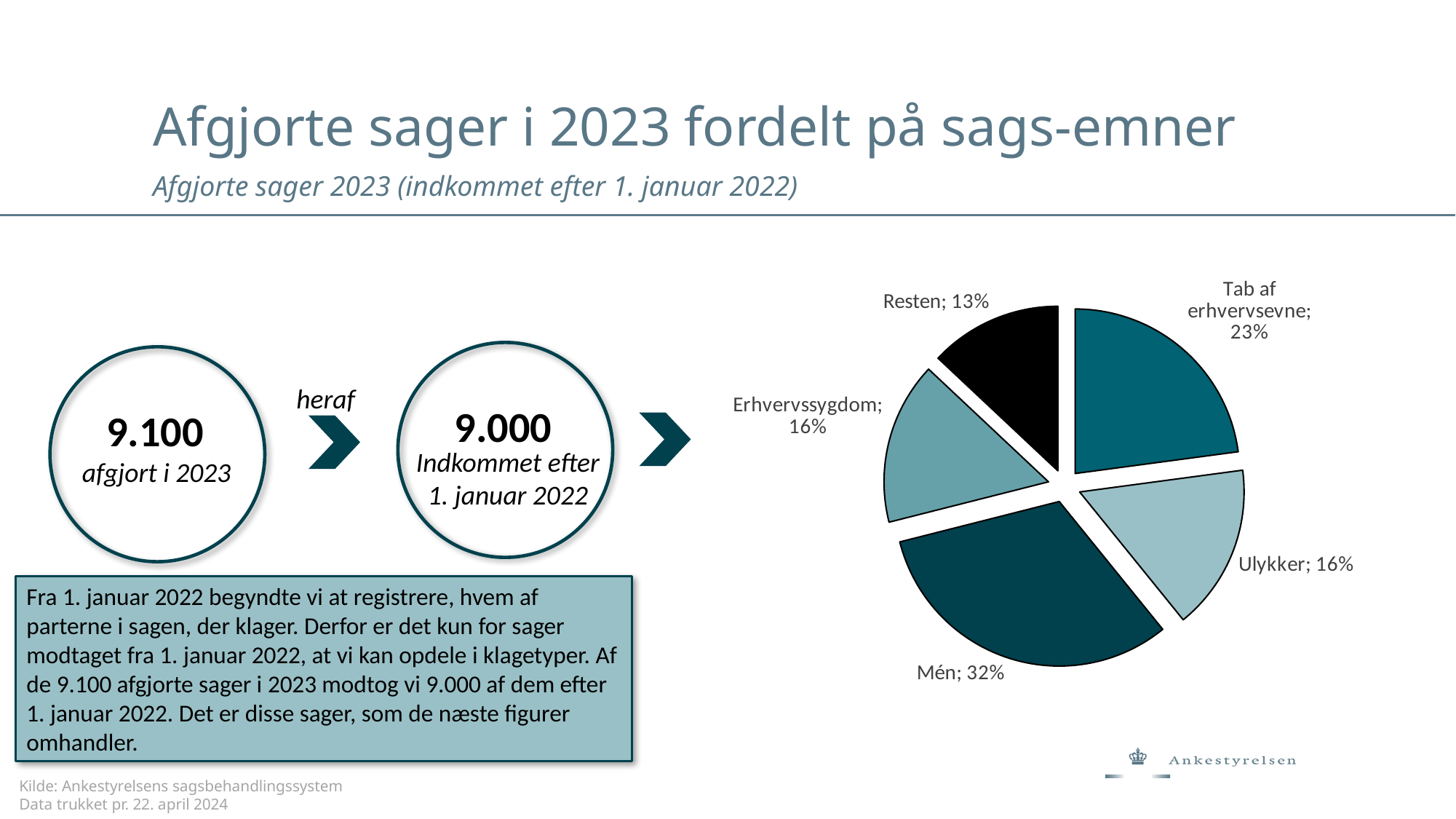
Which category has the largest slice in the pie chart? Mén What share of the pie chart does Tab af erhvervsevne account for? 23% What share of the pie chart does Resten account for? 13% How many percentage points larger is the Mén slice than the Tab af erhvervsevne slice? 9 Which slice is larger, Tab af erhvervsevne or Ulykker? Tab af erhvervsevne How many slices does the pie chart have? 5 Which slice of the pie chart is coloured black? Resten What is the combined share of Ulykker and Erhvervssygdom in the pie chart? 32% What share of the pie chart does Mén account for? 32% What share of the pie chart does Erhvervssygdom account for? 16% What type of chart is shown on the slide? Pie chart Which category has the smallest slice in the pie chart? Resten